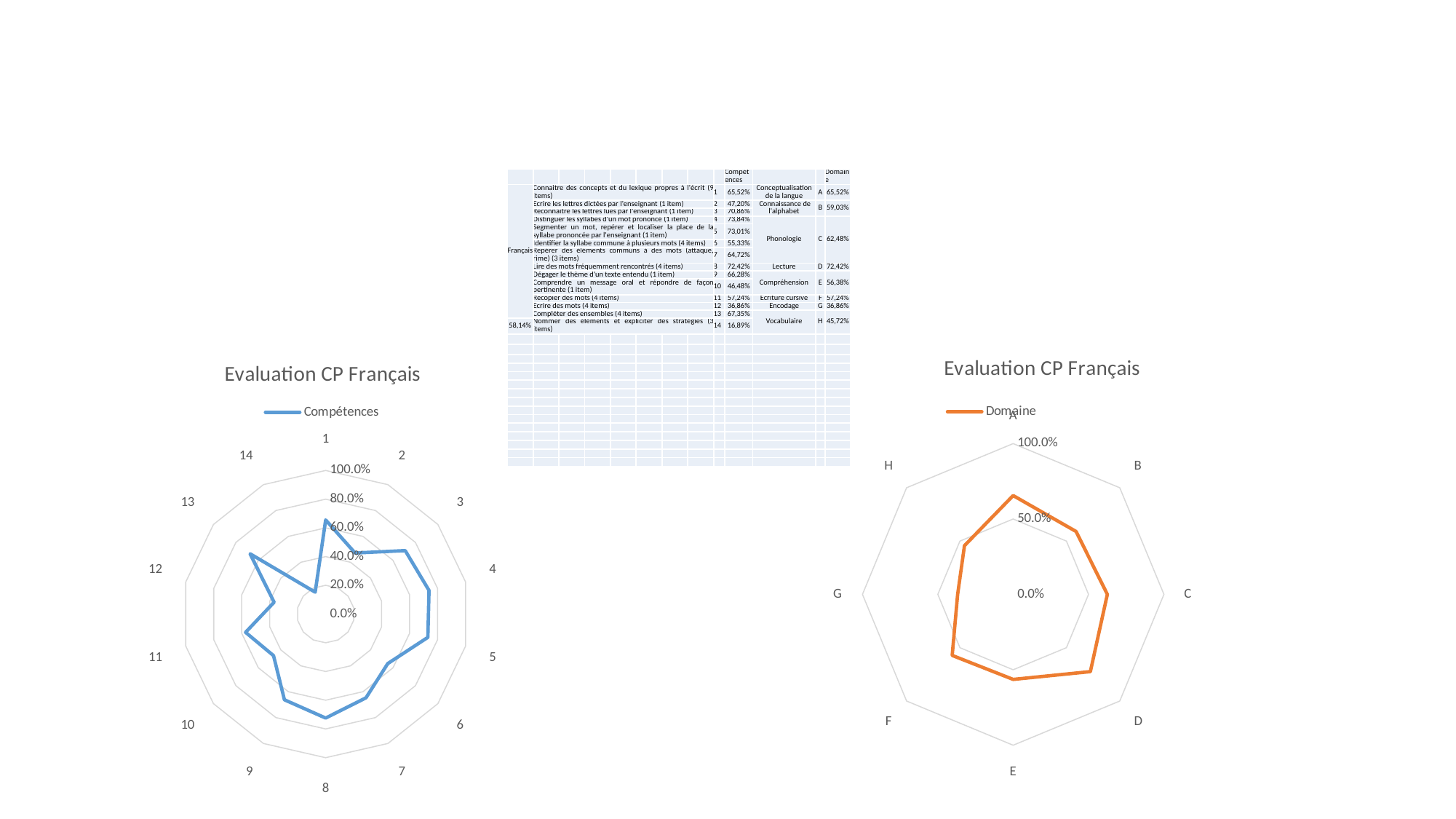
In the left chart (Compétences), which category has the lowest value? 14 In the right chart (Domaine), is the value for G greater or less than 50.0%? less In the right chart (Domaine), which category has the lowest value? G In the left chart (Compétences), is the value for category 4 greater or less than 60.0%? greater What kind of chart is the left chart titled 'Evaluation CP Français'? Radar chart In the right chart (Domaine), which is larger, the value for A or the value for G? A What colour is the Compétences line in the left chart? Blue In the left chart (Compétences), is the value for category 14 greater or less than 40.0%? less What is the name of the series shown in the right chart's legend? Domaine How many categories are plotted on the right radar chart (Domaine)? 8 How many categories are plotted on the left radar chart (Compétences)? 14 How many series does the legend of the left chart list? 1